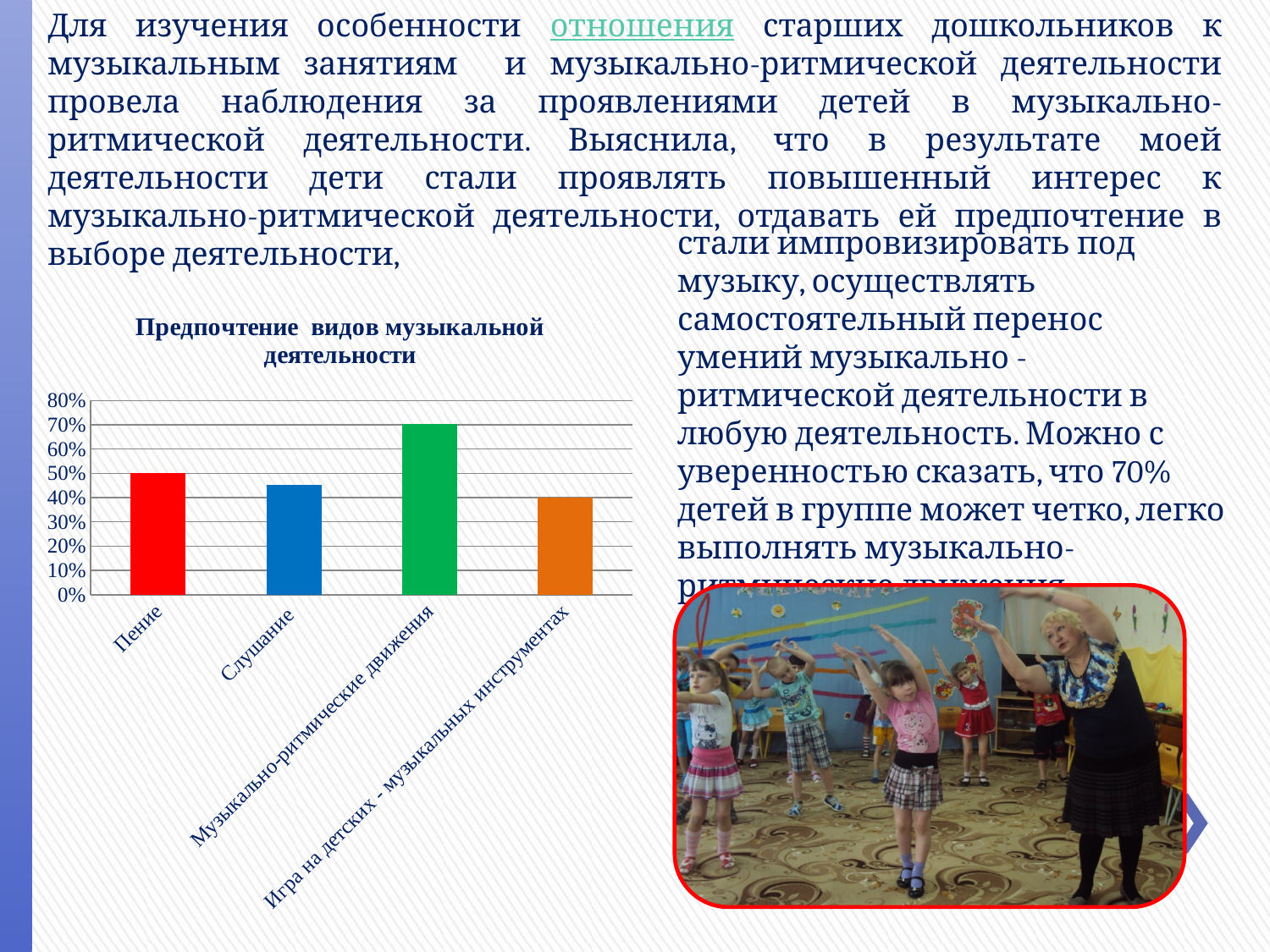
What is the difference between the values for Музыкально-ритмические движения and Пение? 20% Is the value for Слушание greater or less than 50%? less What colour is the bar for Музыкально-ритмические движения? green Which is larger, the value for Пение or the value for Слушание? Пение How many categories are shown in the chart? 4 What is the value for Игра на детских музыкальных инструментах? 40% What is the title of the chart? Предпочтение видов музыкальной деятельности What is the value for Пение? 50% What is the value for Музыкально-ритмические движения? 70% What kind of chart is shown on the slide? bar chart Which category has the highest value? Музыкально-ритмические движения Which category has the lowest value? Игра на детских музыкальных инструментах